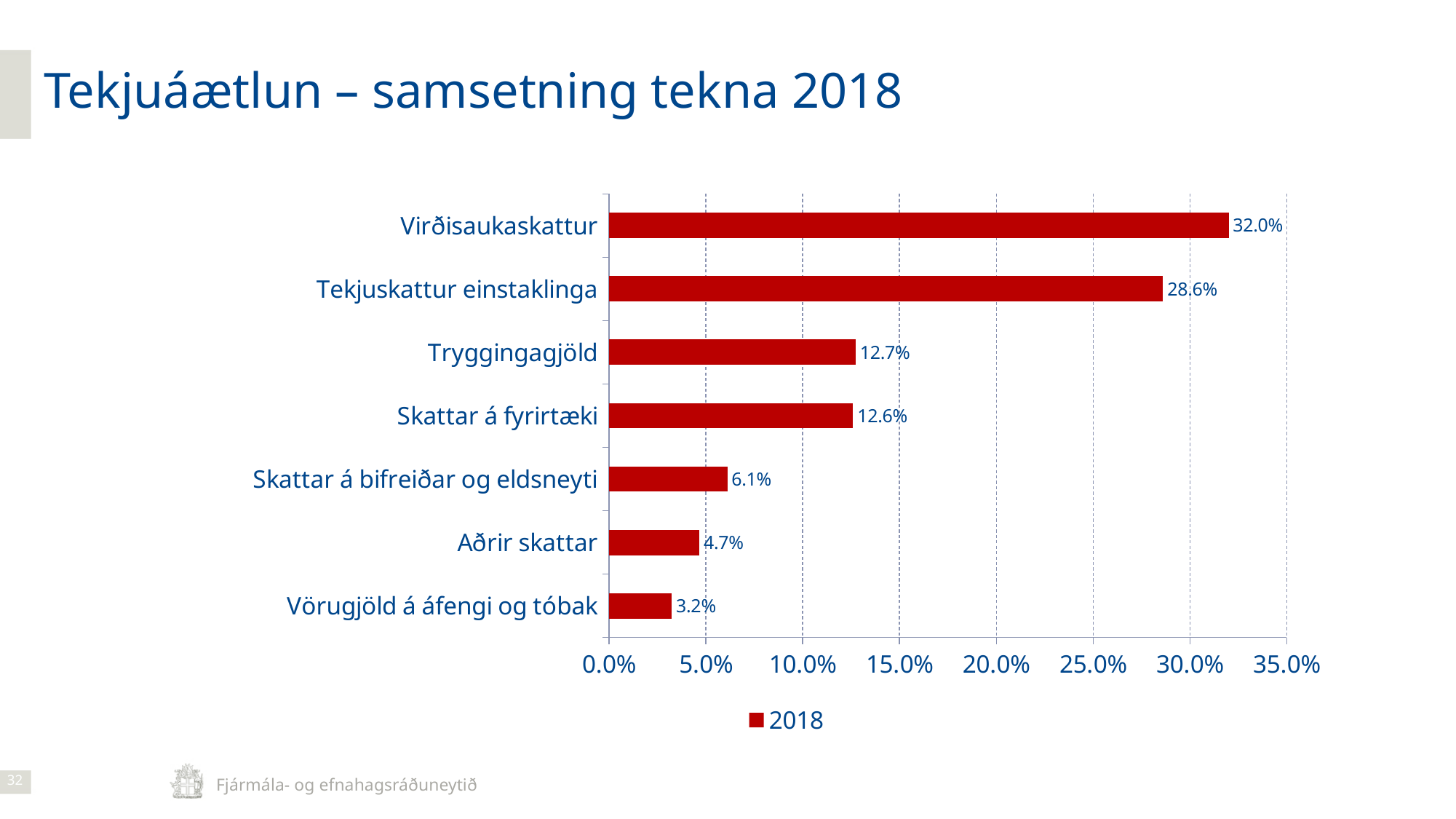
What is the value for Vörugjöld á áfengi og tóbak? 3.2% How many categories are shown in the chart? 7 What is the value for Skattar á bifreiðar og eldsneyti? 6.1% Which category has the lowest value? Vörugjöld á áfengi og tóbak What is the difference between Aðrir skattar and Vörugjöld á áfengi og tóbak? 1.5% What is the value for Virðisaukaskattur? 32.0% What kind of chart is shown on the slide? Bar chart Is the value for Tekjuskattur einstaklinga greater or less than 25.0%? greater How many series does the legend list? 1 What is the difference between Virðisaukaskattur and Tekjuskattur einstaklinga? 3.4% Which category has the highest value? Virðisaukaskattur Which is larger, Skattar á bifreiðar og eldsneyti or Aðrir skattar? Skattar á bifreiðar og eldsneyti